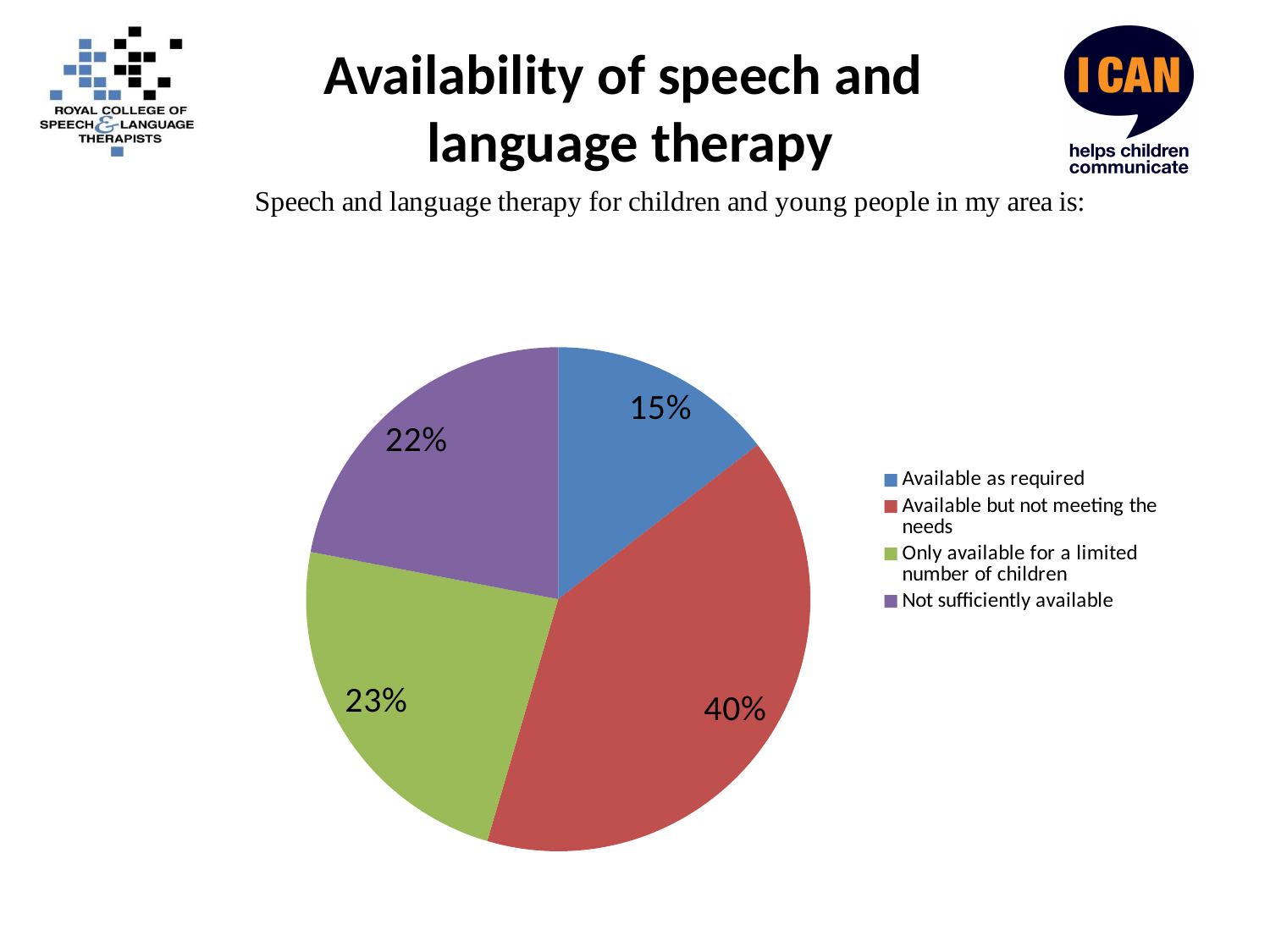
What colour is the slice for 'Only available for a limited number of children'? green What is the difference in percentage points between 'Available but not meeting the needs' and 'Available as required'? 25 What kind of chart is shown on the slide? pie chart Which is larger: the share for 'Available as required' or the share for 'Not sufficiently available'? Not sufficiently available What percentage of respondents said speech and language therapy is 'Available as required'? 15% Which category has the largest share of the pie? Available but not meeting the needs What percentage of respondents said speech and language therapy is 'Not sufficiently available'? 22% What percentage of respondents said speech and language therapy is 'Available but not meeting the needs'? 40% What percentage of respondents said speech and language therapy is 'Only available for a limited number of children'? 23% How many categories does the pie chart show? 4 What is the title of the slide containing the chart? Availability of speech and language therapy Which category has the smallest share of the pie? Available as required